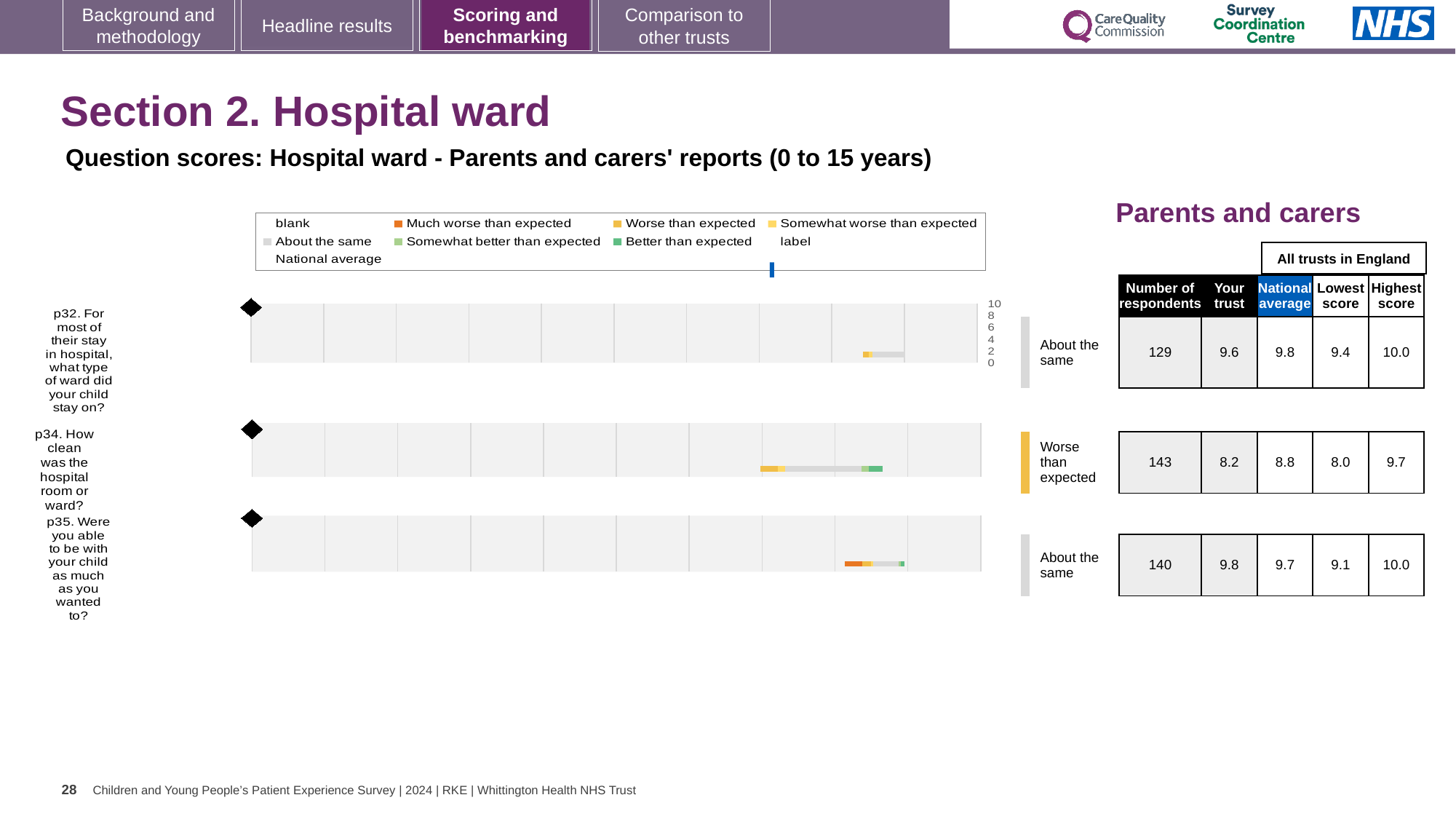
For p35, which is larger: the 'Your trust' score or the national average? Your trust Which question has the highest number of respondents? p34 Which benchmark category is p34 (How clean was the hospital room or ward?) assigned to? Worse than expected What is the 'Your trust' score for p34 (How clean was the hospital room or ward?)? 8.2 What is the difference between the highest score (9.7) and the lowest score (8.0) for p34? 1.7 Which question has the lowest 'Your trust' score? p34 How many respondents answered p35 (Were you able to be with your child as much as you wanted to)? 140 How many questions (p32, p34, p35) are plotted in the hospital ward chart? 3 What is the highest score across all trusts in England for p34? 9.7 In the legend, what colour represents 'Much worse than expected'? orange What kind of chart is used to show the question scores for the hospital ward section? bar chart What is the national average score for p32 (what type of ward did your child stay on)? 9.8